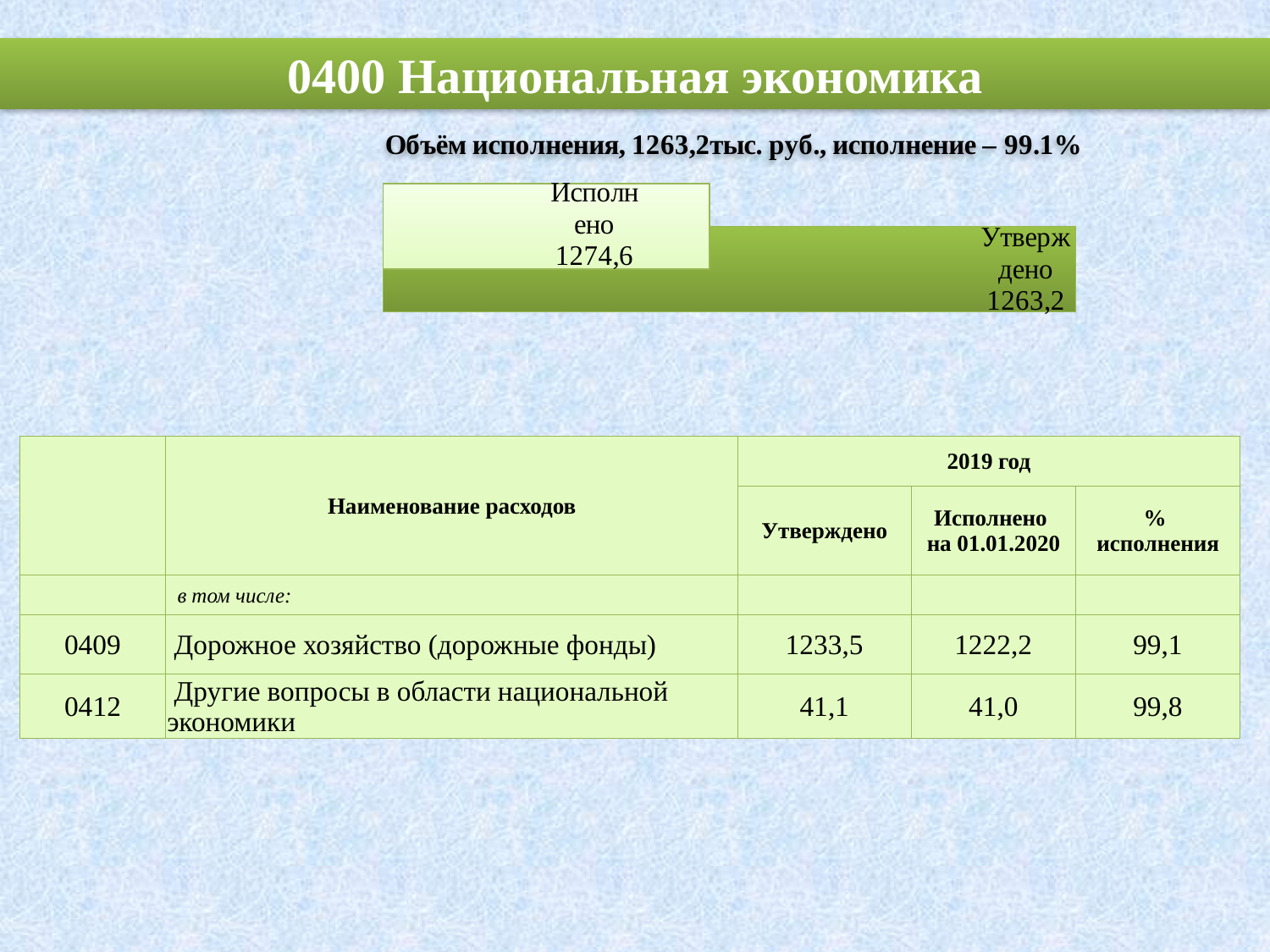
What value is shown for the bar labelled "Утверждено"? 1263,2 What kind of chart is shown on the slide? bar chart What value is shown for the bar labelled "Исполнено"? 1274,6 Which bar in the chart is drawn in the darker green colour? Утверждено How many bars does the chart show? 2 Is the value labelled for "Утверждено" greater or less than 1500? less Is the value labelled for "Исполнено" greater or less than 1000? greater What is the difference between the values labelled "Исполнено" (1274,6) and "Утверждено" (1263,2)? 11,4 Which bar in the chart is drawn in the lighter green colour? Исполнено